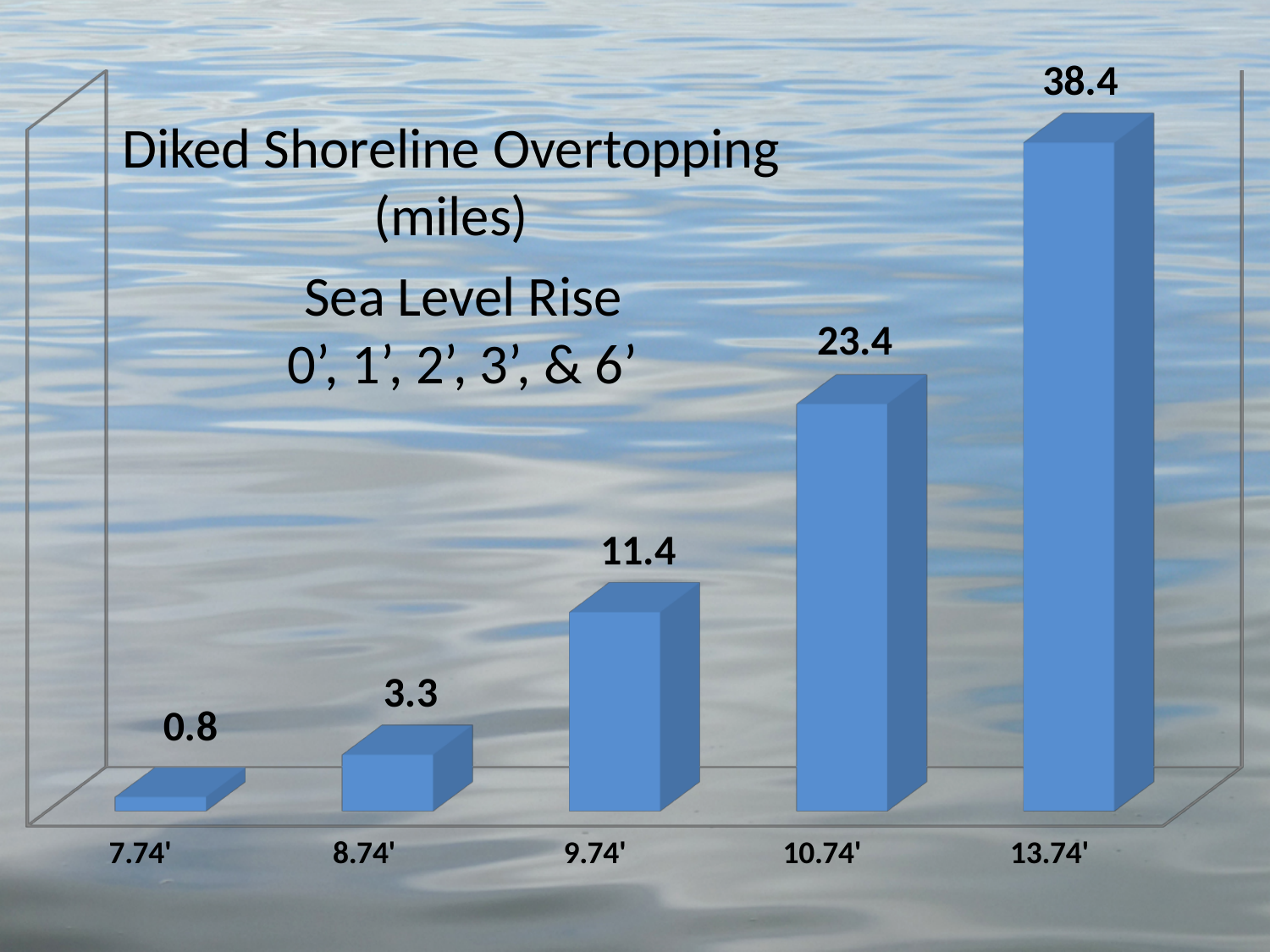
What is the value for the 13.74' category? 38.4 What kind of chart is this? bar chart Do the values rise or fall from left to right along the x axis? rise What is the difference between the values for 9.74' and 8.74'? 8.1 What is the value for the 9.74' category? 11.4 Which is larger, the value for 10.74' or the value for 9.74'? 10.74' What is the value for the 7.74' category? 0.8 What is the difference between the values for 13.74' and 10.74'? 15.0 How many categories are shown on the x axis? 5 What unit is given in the chart title for diked shoreline overtopping? miles Which category has the highest value? 13.74' Which category has the lowest value? 7.74'